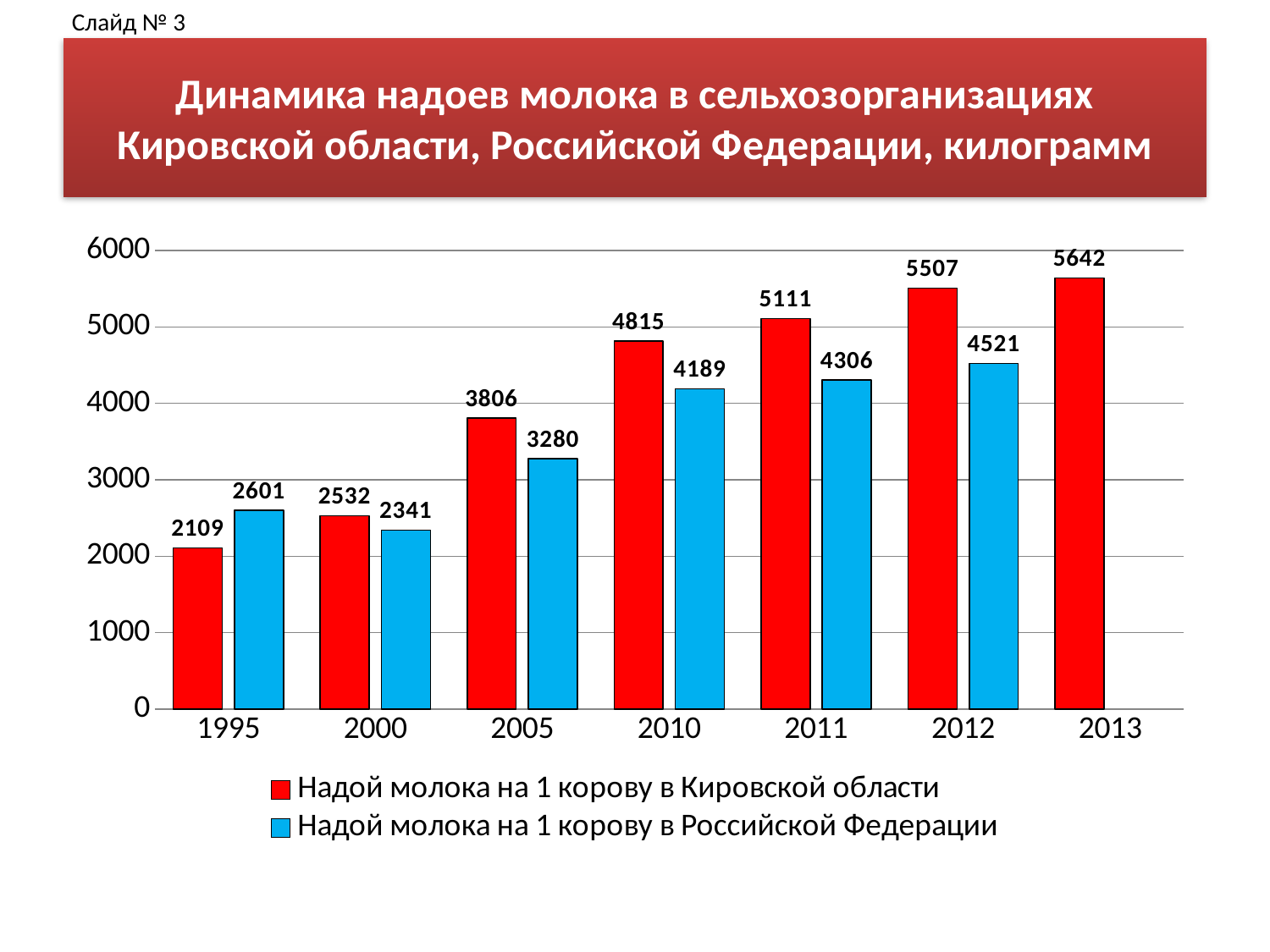
What was the milk yield per cow in the Kirov region in 2013? 5642 How many years are shown on the x axis? 7 What is the difference between the Kirov region and Russian Federation milk yield per cow in 2012? 986 Does the milk yield per cow in the Kirov region rise or fall from 1995 to 2013? Rises What was the milk yield per cow in the Russian Federation in 2005? 3280 In 1995, which was higher: the milk yield per cow in the Kirov region or in the Russian Federation? Russian Federation What was the milk yield per cow in the Kirov region in 2010? 4815 In which year was the milk yield per cow in the Russian Federation the highest? 2012 How many series does the legend list? 2 Which colour represents the milk yield per cow in the Russian Federation? Blue In which year was the milk yield per cow in the Kirov region the lowest? 1995 What type of chart is shown on the slide? Bar chart